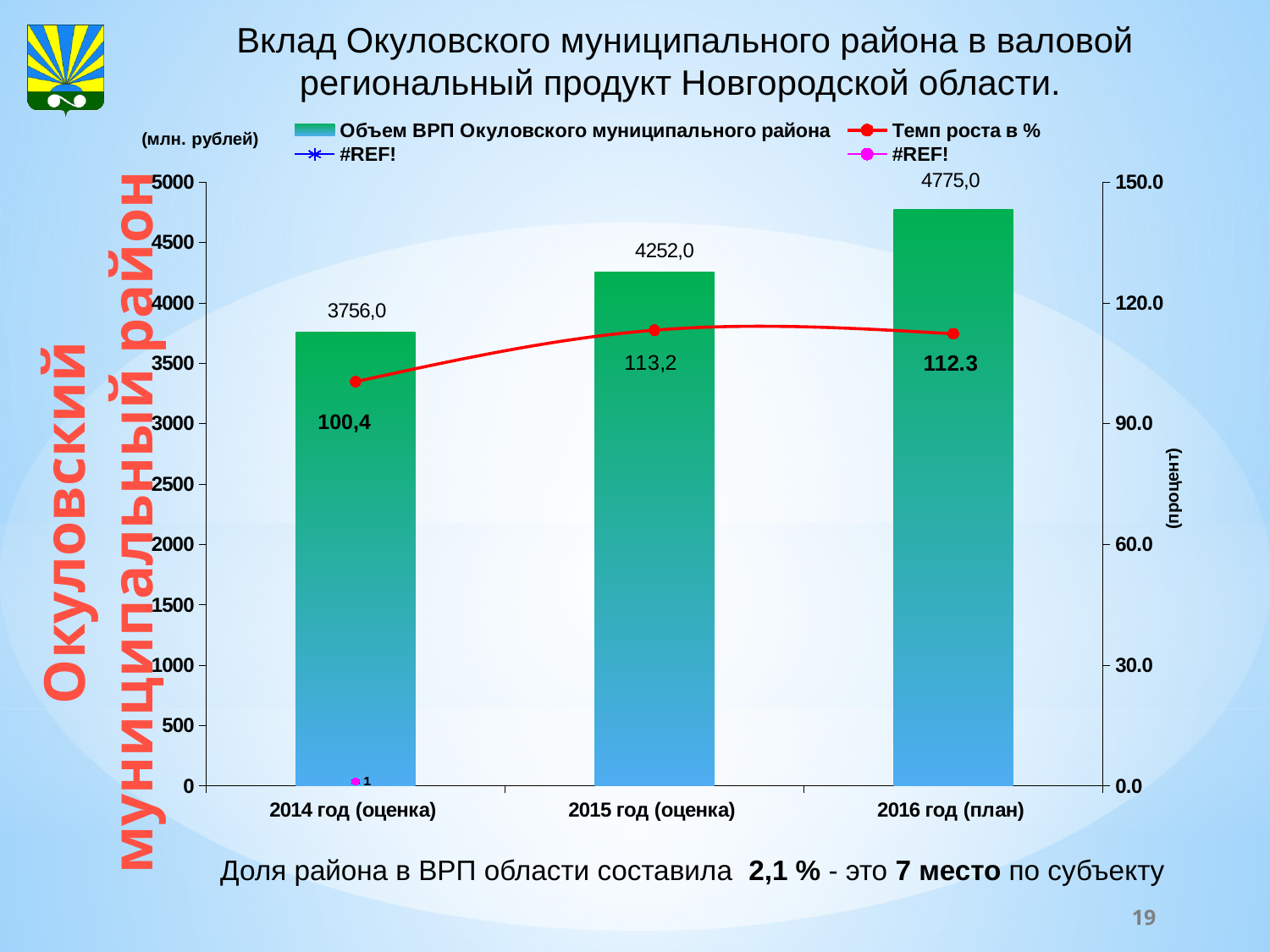
How many year categories are shown on the x axis? 3 What is the Темп роста в % value for 2014 год (оценка)? 100,4 Is the Объем ВРП value for 2015 год (оценка) greater or less than 4000? greater What is the difference in Объем ВРП Окуловского муниципального района between 2016 год (план) and 2015 год (оценка)? 523,0 What is the value of Объем ВРП Окуловского муниципального района for 2016 год (план)? 4775,0 What is the value of Объем ВРП Окуловского муниципального района for 2014 год (оценка)? 3756,0 Which year has the lowest Темп роста в %? 2014 год (оценка) Which year has the highest Объем ВРП Окуловского муниципального района? 2016 год (план) What is the Темп роста в % value for 2015 год (оценка)? 113,2 Do the Объем ВРП bars rise or fall from 2014 to 2016? rise What unit is shown in the label at the top left of the chart's left axis? млн. рублей Which is larger: the Объем ВРП for 2015 год (оценка) or for 2014 год (оценка)? 2015 год (оценка)